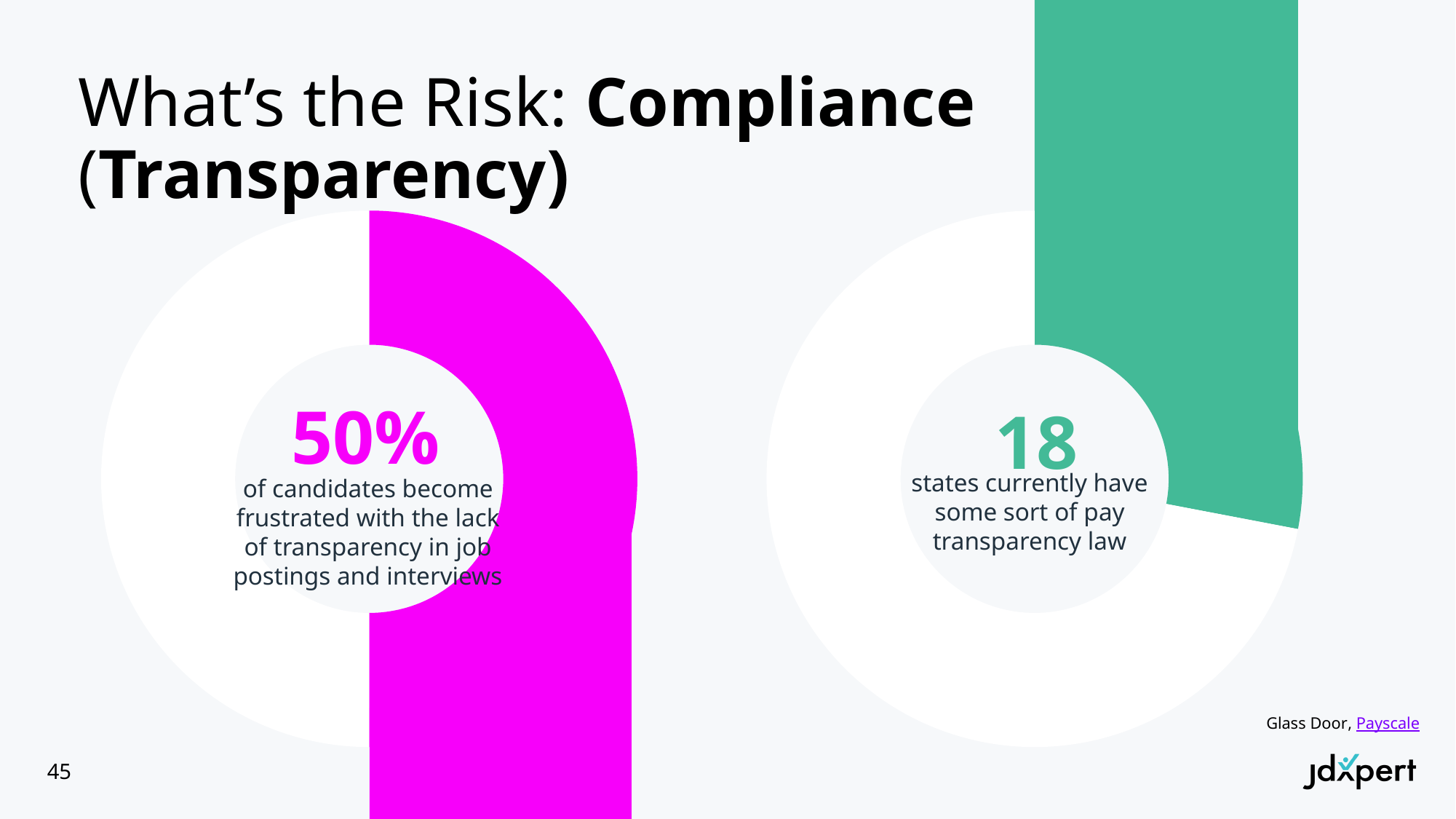
What colour is the filled segment of the left donut chart? Magenta (pink) How many donut charts are on the slide? 2 What sources are cited for the charts on the slide? Glass Door, Payscale In the right donut chart, how many states currently have some sort of pay transparency law? 18 What kind of charts are shown on the slide? Donut (pie) charts Does the green segment of the right donut chart cover more or less than half of the ring? less What share of the left donut chart is filled by the magenta segment? 50% In the left donut chart, what percentage of candidates become frustrated with the lack of transparency in job postings and interviews? 50%